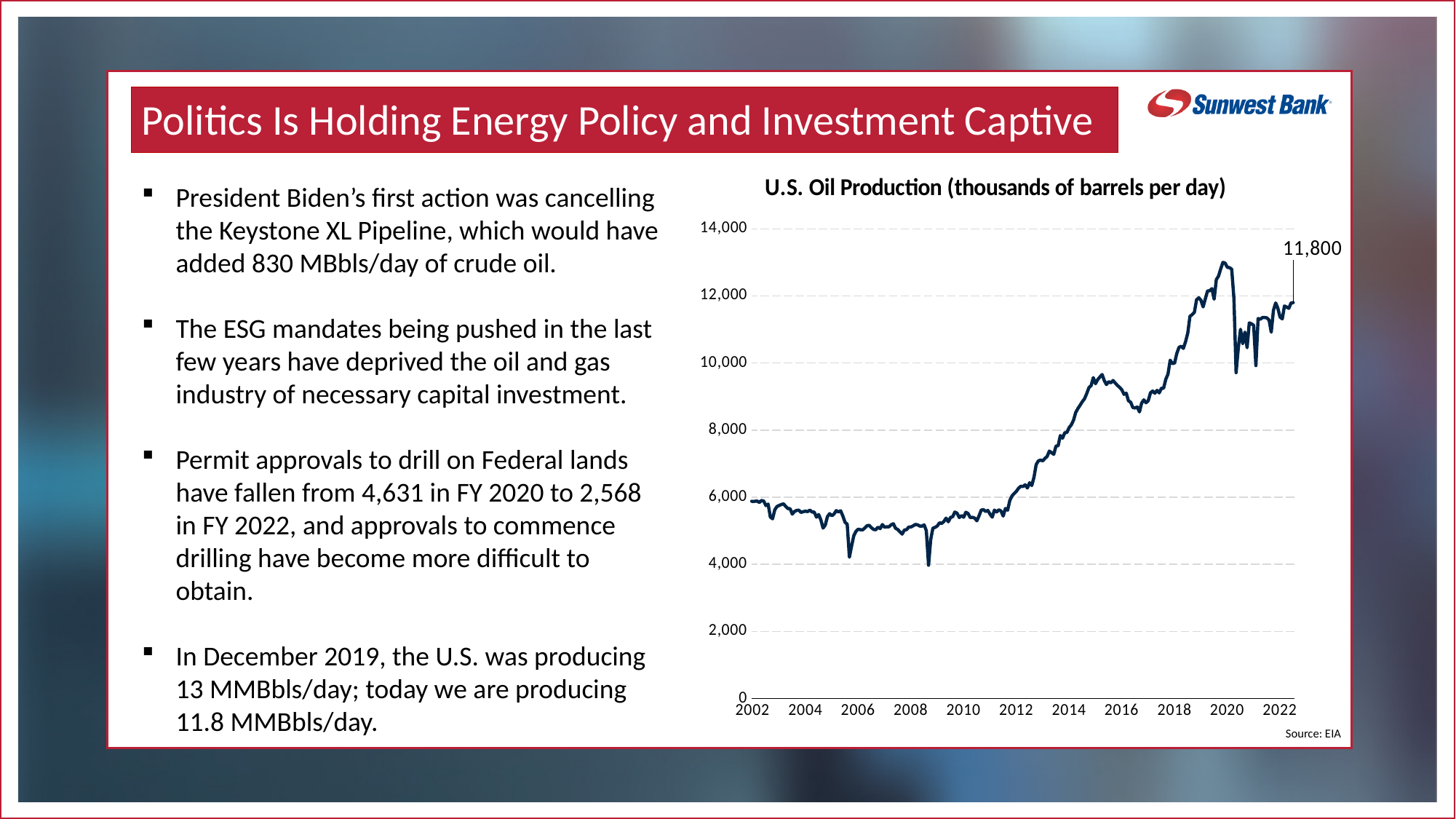
Which is larger, the value in 2002 or the value in 2022? 2022 How many year labels are shown on the x axis? 11 Which is larger, the value in 2012 or the value in 2016? 2016 What kind of chart is shown on the slide? Line chart Is the value for 2002 greater or less than 8,000? less Is the highest point of the line greater or less than 12,000? greater Overall, does U.S. oil production rise or fall from 2002 to 2022? Rise What value is labelled at the end of the line in 2022? 11,800 Is the value for 2010 greater or less than 6,000? less What is the title of the chart? U.S. Oil Production (thousands of barrels per day) What source is cited for the chart? EIA